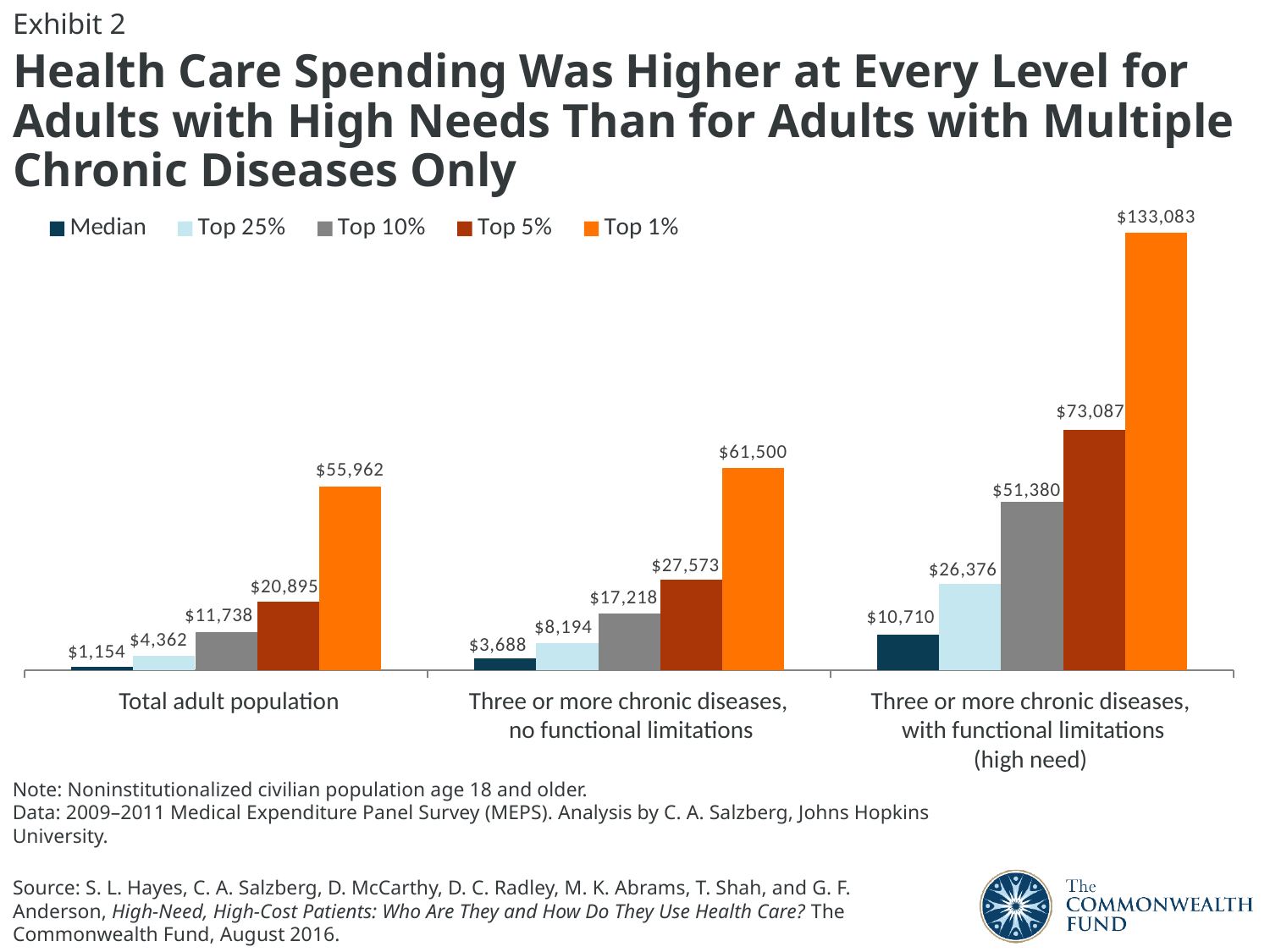
What is the Top 10% value for the 'Three or more chronic diseases, no functional limitations' group? $17,218 How many series does the legend list? 5 How many population groups are shown on the x axis? 3 What is the Median value for the 'Total adult population' group? $1,154 Which group has the lowest Median value? Total adult population Which is larger: the Top 10% value for the high-need group or the Top 1% value for the total adult population? Top 1% value for the total adult population What is the Top 25% value for the high-need group (three or more chronic diseases, with functional limitations)? $26,376 What is the Top 1% value for the 'Three or more chronic diseases, with functional limitations (high need)' group? $133,083 What is the difference between the Top 1% value for the high-need group and the Top 1% value for the total adult population? $77,121 What is the difference between the Top 5% value for the high-need group and the Top 5% value for the 'no functional limitations' group? $45,514 What kind of chart is shown on the slide? Bar chart Which group has the highest Top 5% value? Three or more chronic diseases, with functional limitations (high need)